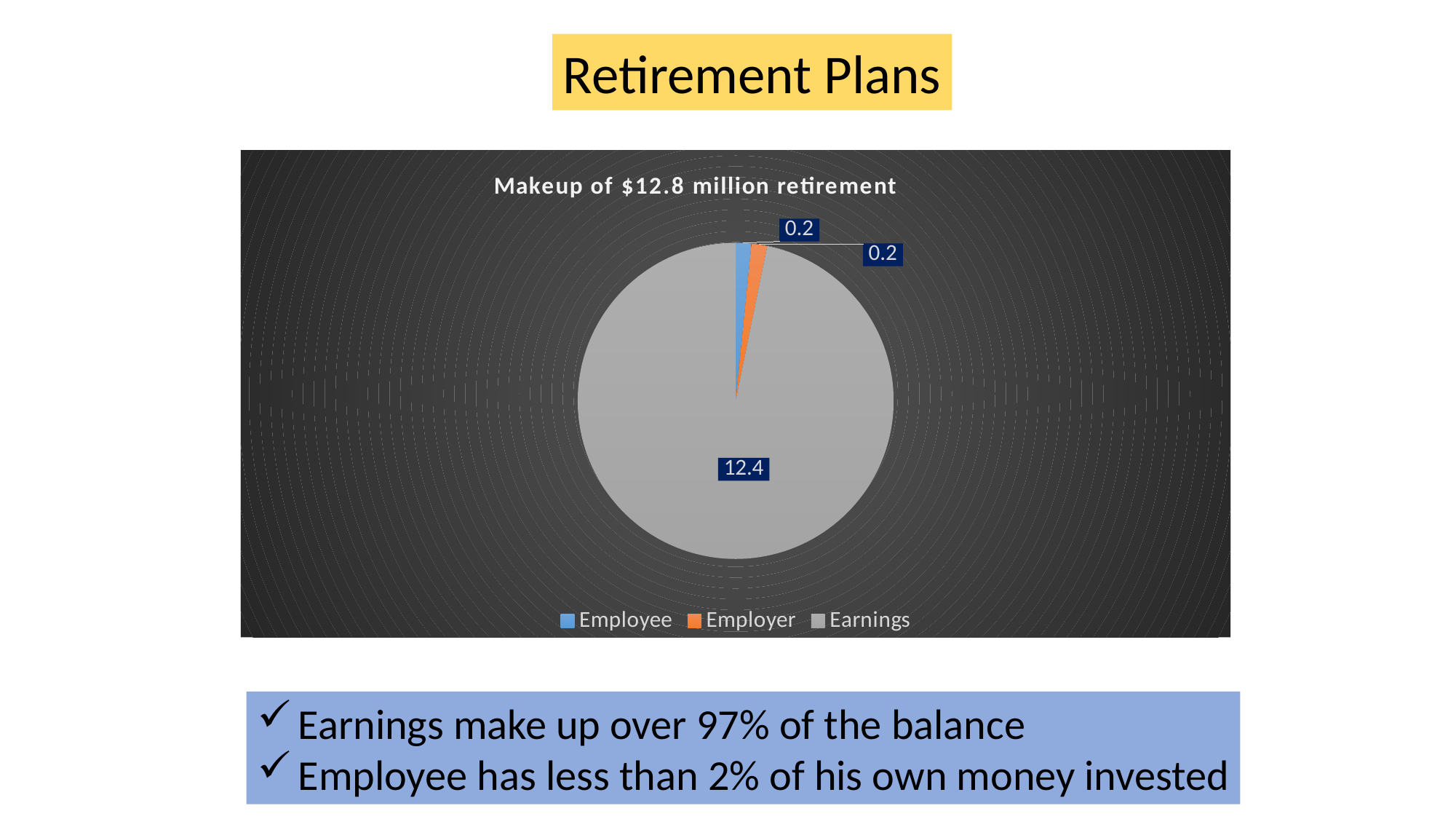
What is the value of the Employer slice? 0.2 Which is larger, the Earnings slice or the Employer slice? Earnings Which category has the largest slice of the pie? Earnings What is the title of the chart? Makeup of $12.8 million retirement What is the total of all three slices in the pie chart? 12.8 What type of chart is shown on the slide? Pie chart What is the value of the Employee slice? 0.2 Which colour represents Employer in the legend? Orange What is the difference between the Earnings value and the Employee value? 12.2 How many entries does the legend list? 3 What is the value of the Earnings slice? 12.4 How many slices does the pie chart have? 3